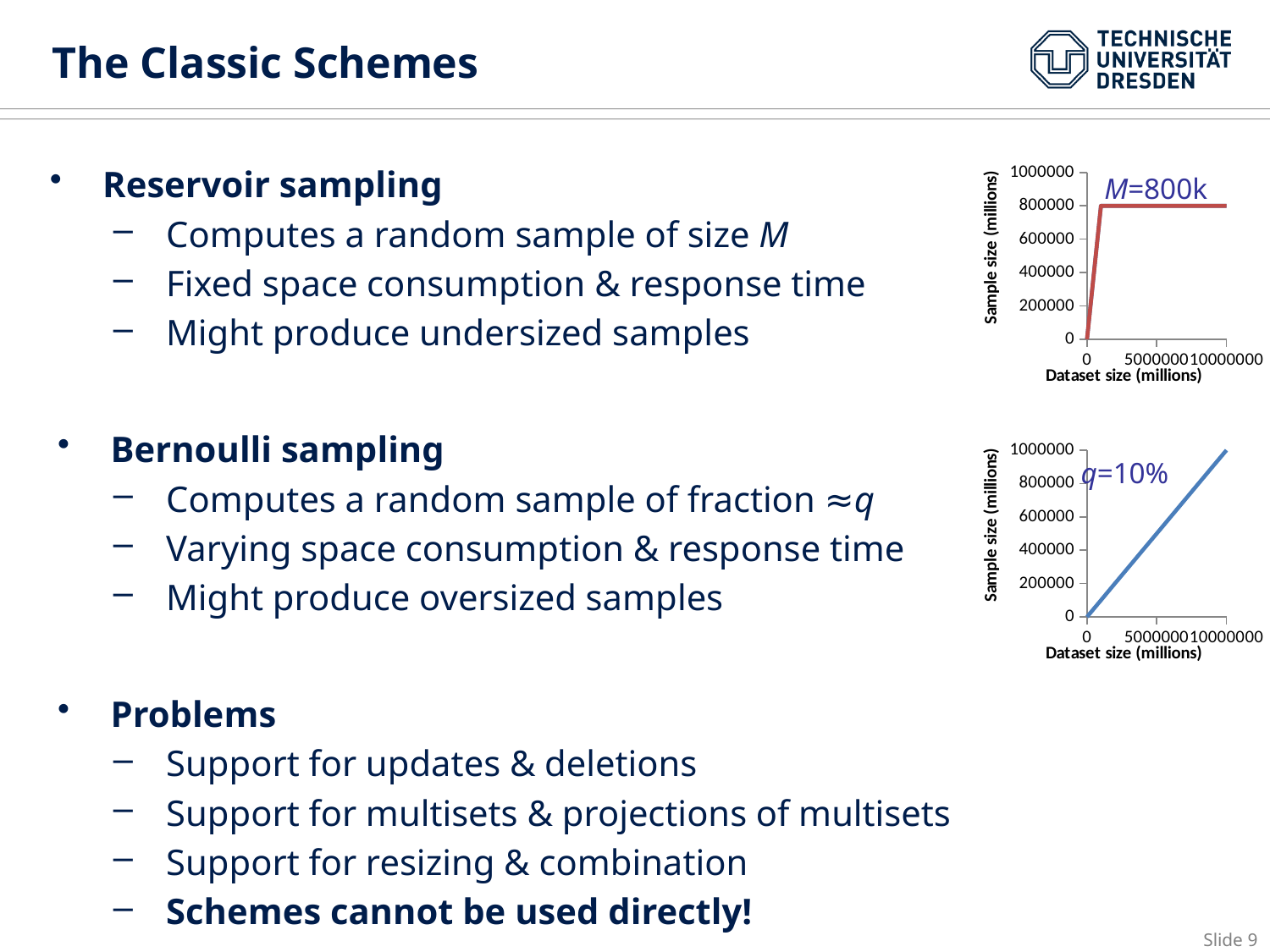
In the top chart (M=800k), at what sample size does the line level off? 800000 What is the label of the x axis in the top chart? Dataset size (millions) In the top chart (M=800k), how does the sample size behave after the initial steep rise as the dataset size increases? stays flat At a dataset size of 10000000, which chart shows the larger sample size, the top chart (M=800k) or the bottom chart (q=10%)? the bottom chart (q=10%) In the top chart (M=800k), is the sample size at a dataset size of 5000000 greater or less than 600000? greater What kind of chart is the bottom chart on the right of the slide? line chart In the bottom chart (q=10%), does the sample size rise or fall as the dataset size increases? rise In the bottom chart (q=10%), what sample size does the line reach at a dataset size of 10000000? 1000000 In the bottom chart (q=10%), is the sample size at a dataset size of 5000000 greater or less than 800000? less What kind of chart is the top chart on the right of the slide? line chart What annotation text is shown inside the bottom chart? q=10%